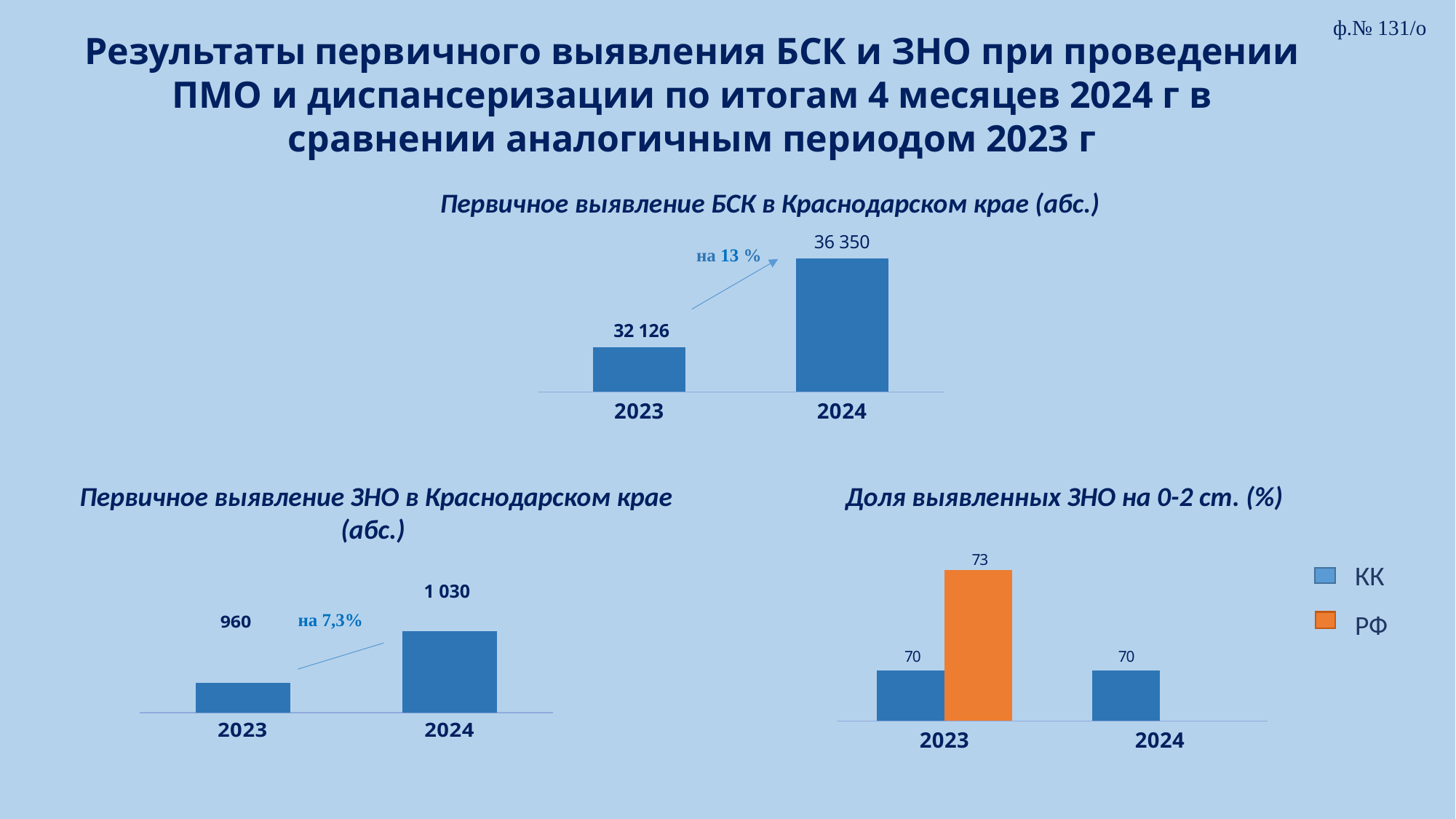
In the chart 'Первичное выявление ЗНО в Краснодарском крае (абс.)', what is the value for 2023? 960 In the chart 'Первичное выявление ЗНО в Краснодарском крае (абс.)', what is the value for 2024? 1 030 In the chart 'Первичное выявление БСК в Краснодарском крае (абс.)', what is the value for 2024? 36 350 In the chart 'Доля выявленных ЗНО на 0-2 ст. (%)', how many series does the legend list? 2 In the chart 'Первичное выявление БСК в Краснодарском крае (абс.)', what is the value for 2023? 32 126 In the chart 'Первичное выявление БСК в Краснодарском крае (абс.)', do the values rise or fall from 2023 to 2024? rise In the chart 'Доля выявленных ЗНО на 0-2 ст. (%)', what is the value for КК in 2024? 70 What type of chart is 'Доля выявленных ЗНО на 0-2 ст. (%)'? bar chart In the chart 'Первичное выявление ЗНО в Краснодарском крае (абс.)', what is the difference between the 2024 and 2023 values? 70 In the chart 'Доля выявленных ЗНО на 0-2 ст. (%)', what is the value for РФ in 2023? 73 In the chart 'Первичное выявление БСК в Краснодарском крае (абс.)', what is the difference between the 2024 and 2023 values? 4 224 In the chart 'Первичное выявление ЗНО в Краснодарском крае (абс.)', which year has the higher value? 2024